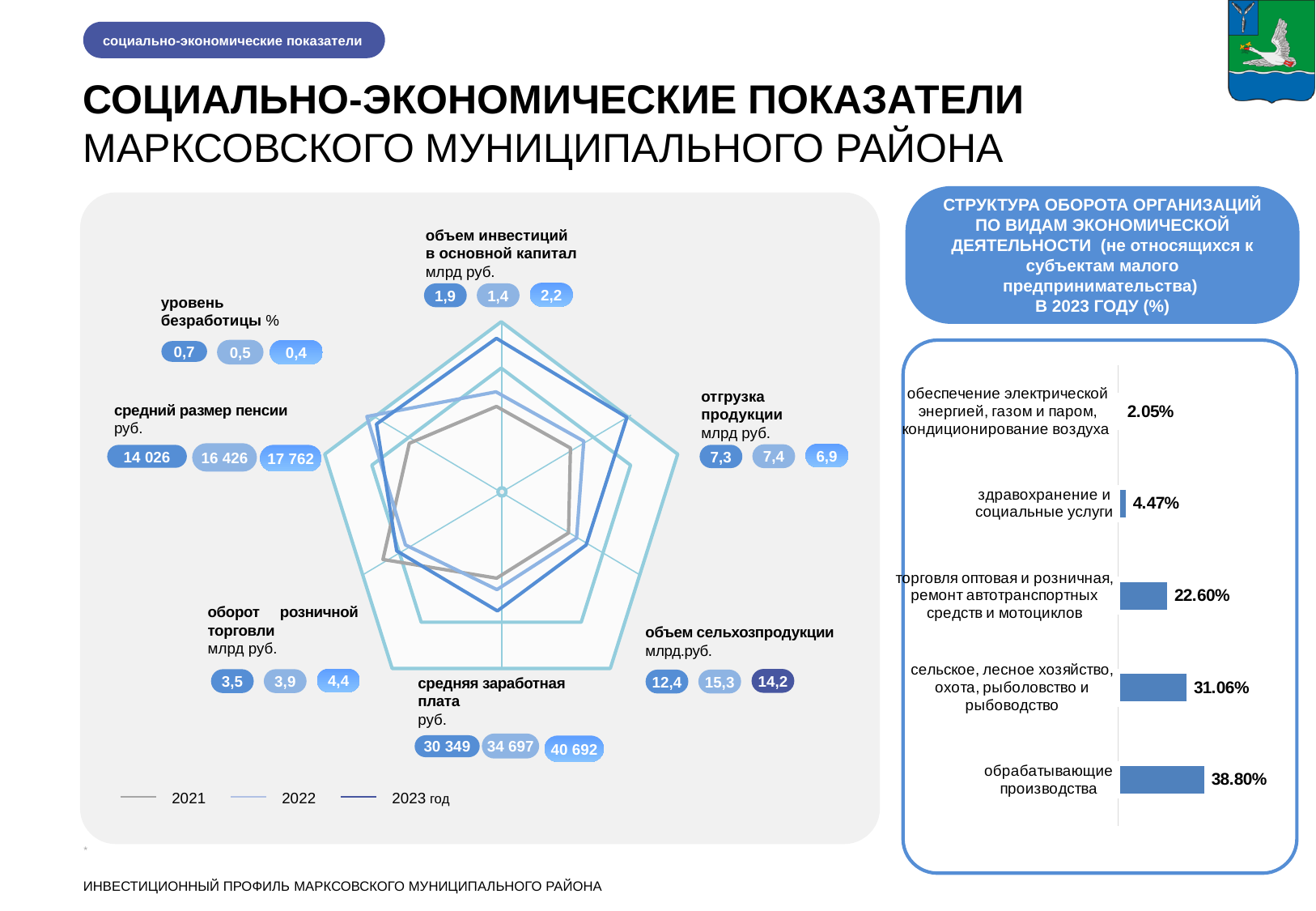
In the bar chart on the right (structure of turnover by economic activity in 2023), what is the value for обрабатывающие производства? 38.80% What kind of chart is the chart on the left side of the slide? Radar chart In the bar chart on the right, which category has the lowest share? обеспечение электрической энергией, газом и паром, кондиционирование воздуха What kind of chart is the chart on the right side of the slide? Bar chart How many categories are shown in the bar chart on the right? 5 In the bar chart on the right, which category has the highest share? обрабатывающие производства In the bar chart on the right, what is the difference between the shares of обрабатывающие производства and сельское, лесное хозяйство, охота, рыболовство и рыбоводство? 7.74 percentage points In the radar chart on the left, which year has the larger value for объем сельхозпродукции: 2022 or 2023? 2022 How many series (years) does the legend of the radar chart on the left list? 3 In the radar chart on the left, does уровень безработицы rise or fall from 2021 to 2023? Falls In the radar chart on the left, what is the value of средняя заработная плата for 2023? 40 692 How many indicators (axes) does the radar chart on the left have? 7